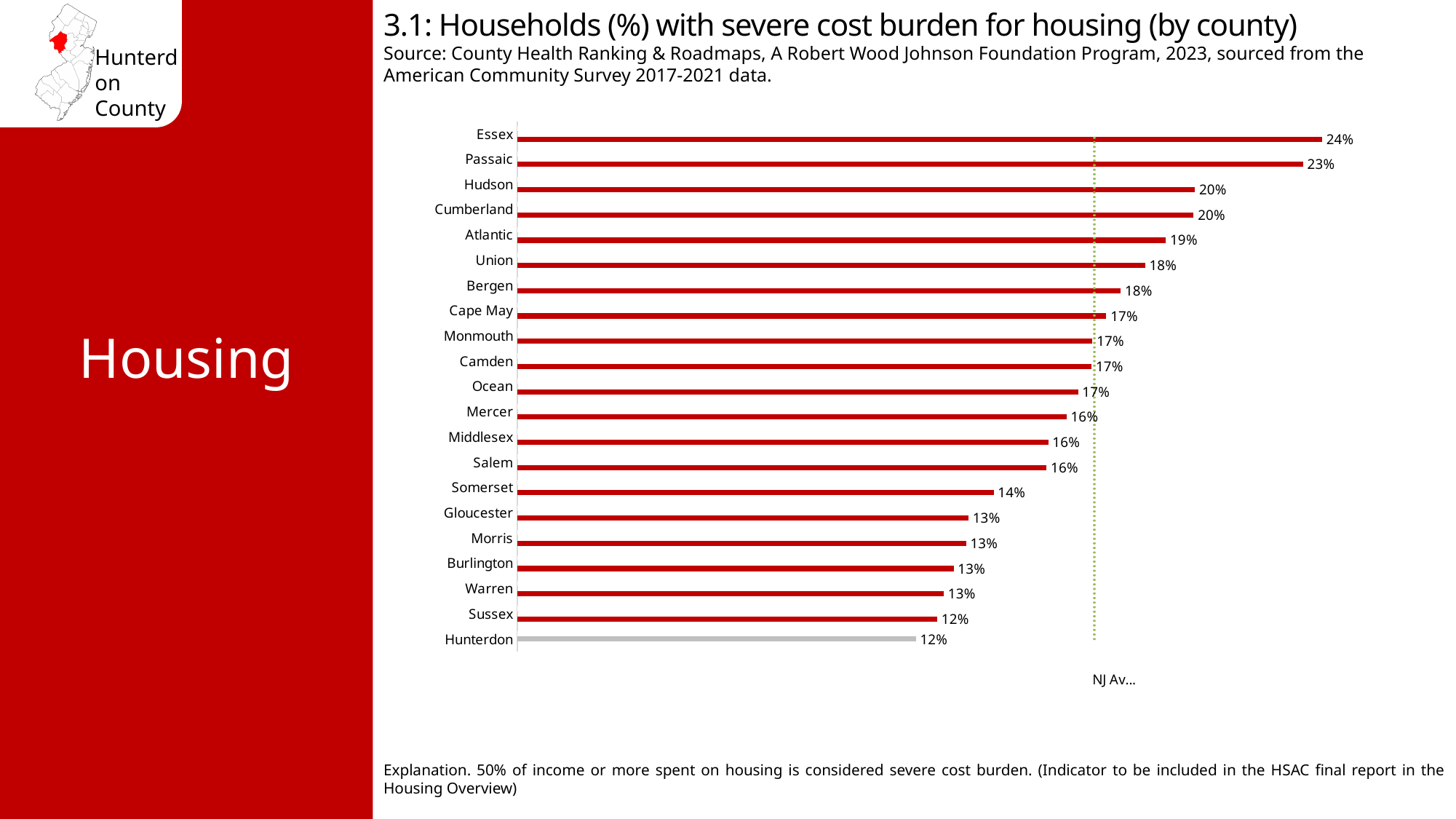
How many counties are shown in the chart? 21 Which county has the highest percentage of households with severe housing cost burden? Essex What is the value shown for Somerset County? 14% Which county's bar is drawn in grey rather than red? Hunterdon What is the value shown for Hunterdon County? 12% What is the difference in percentage points between Essex and Hunterdon? 12 percentage points Which has a higher value, Union or Gloucester? Union Which has a higher value, Hudson or Morris? Hudson What percentage of households in Essex County have a severe housing cost burden? 24% What kind of chart is shown on the slide? Bar chart What is the difference in percentage points between Passaic and Somerset? 9 percentage points What is the value shown for Atlantic County? 19%